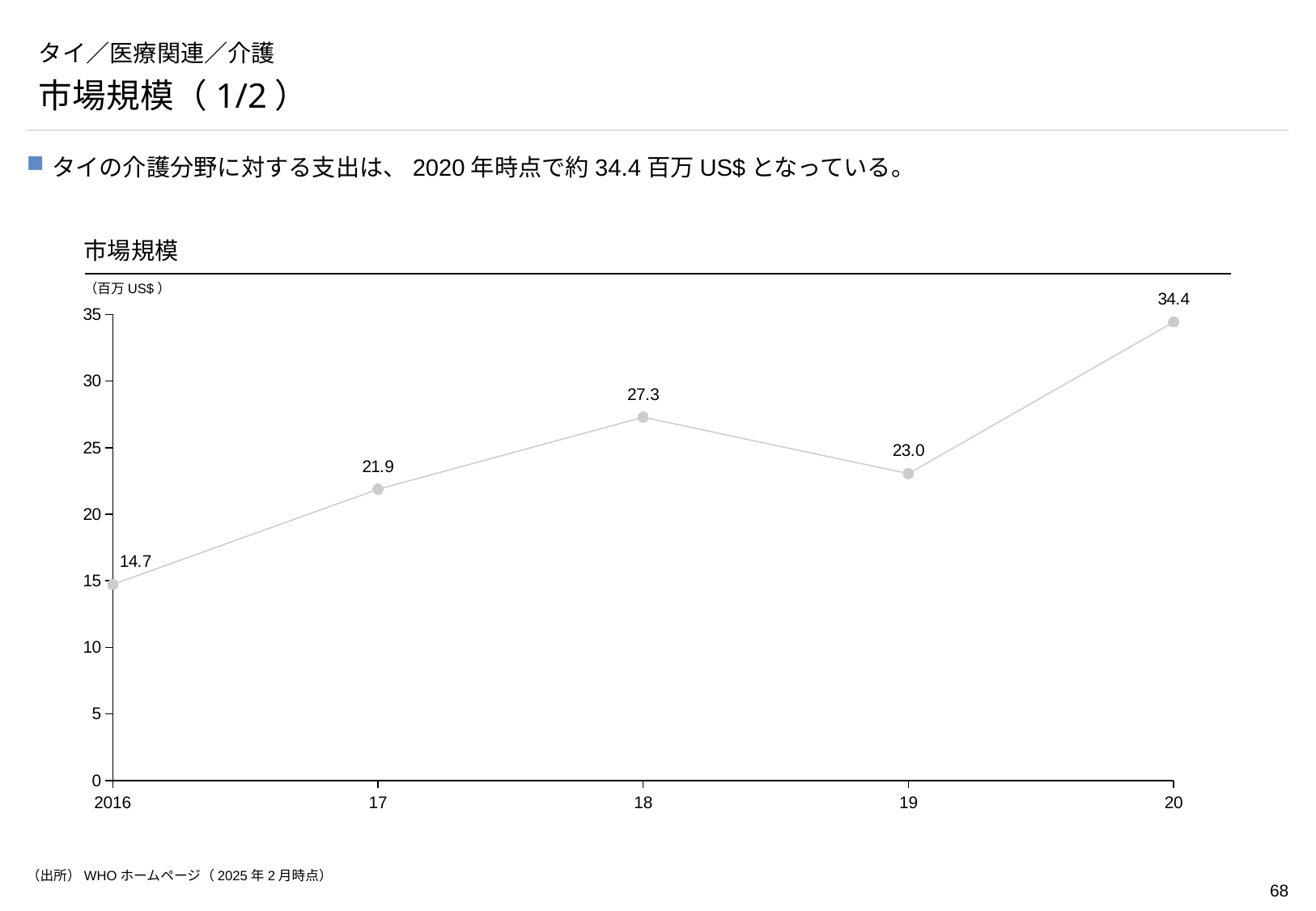
What is the market size value for 2016? 14.7 How many data points are plotted on the chart? 5 What type of chart is shown on the slide? line chart Does the market size value rise or fall from 2018 to 2019? fall What is the market size value for 2018? 27.3 What is the market size value for 2020? 34.4 What unit is shown for the chart's values? 百万US$ What is the difference between the market size values for 2018 and 2017? 5.4 Which year has the lowest market size value? 2016 Which year has a larger market size value, 2018 or 2019? 2018 What is the difference between the market size values for 2020 and 2019? 11.4 Which year has the highest market size value? 2020